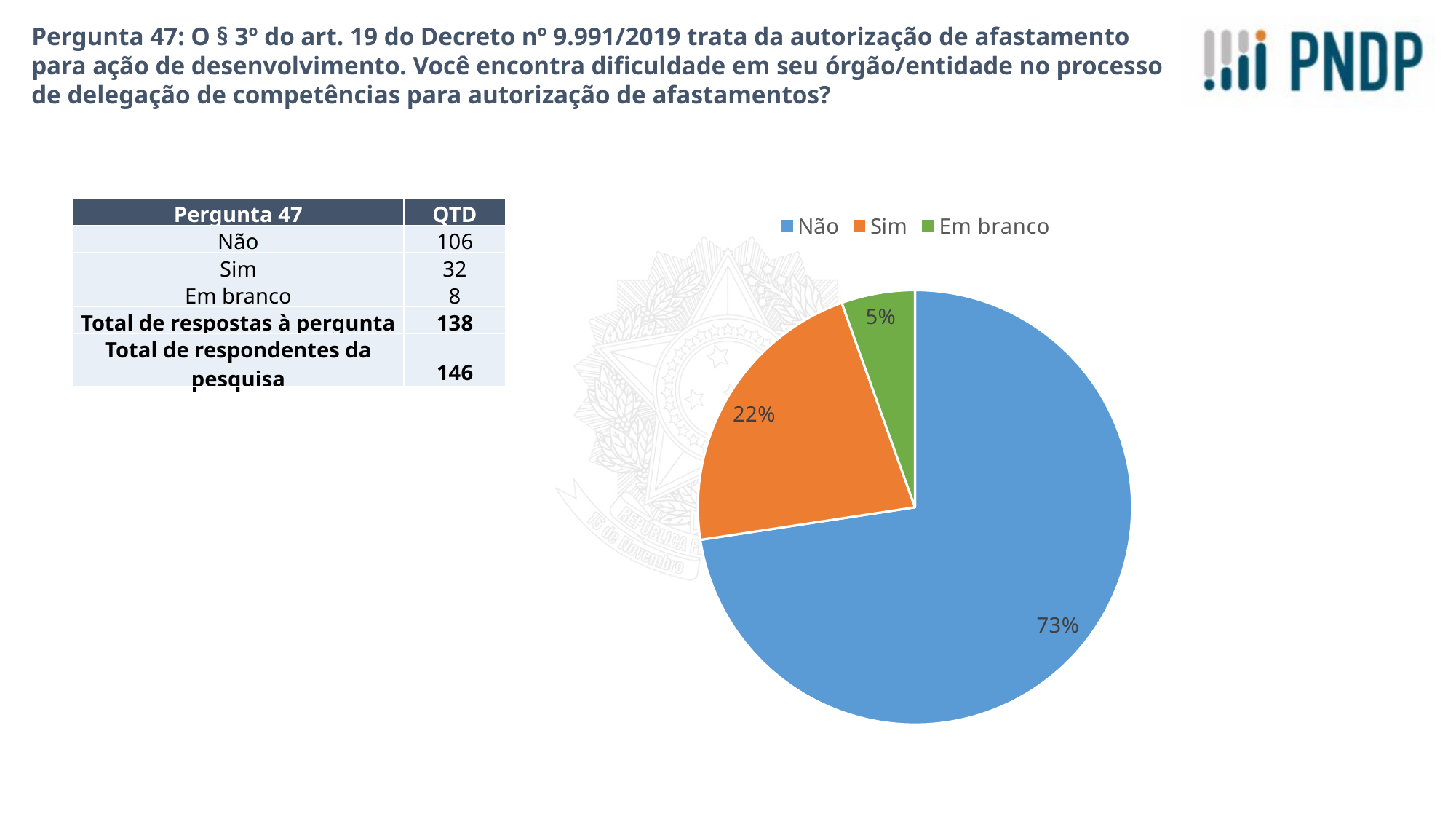
What is the difference in percentage points between the 'Não' slice and the 'Sim' slice? 51% Which legend entry is shown in green? Em branco What colour is the 'Sim' slice in the pie chart? orange What share of the pie does the 'Sim' slice represent? 22% Which slice of the pie chart is the largest? Não What kind of chart is shown on the slide? pie chart How many slices does the pie chart have? 3 What share of the pie does the 'Não' slice represent? 73% Which slice of the pie chart is the smallest? Em branco How many entries does the legend of the pie chart list? 3 What share of the pie does the 'Em branco' slice represent? 5% Which is larger in the pie chart, the 'Sim' slice or the 'Em branco' slice? Sim